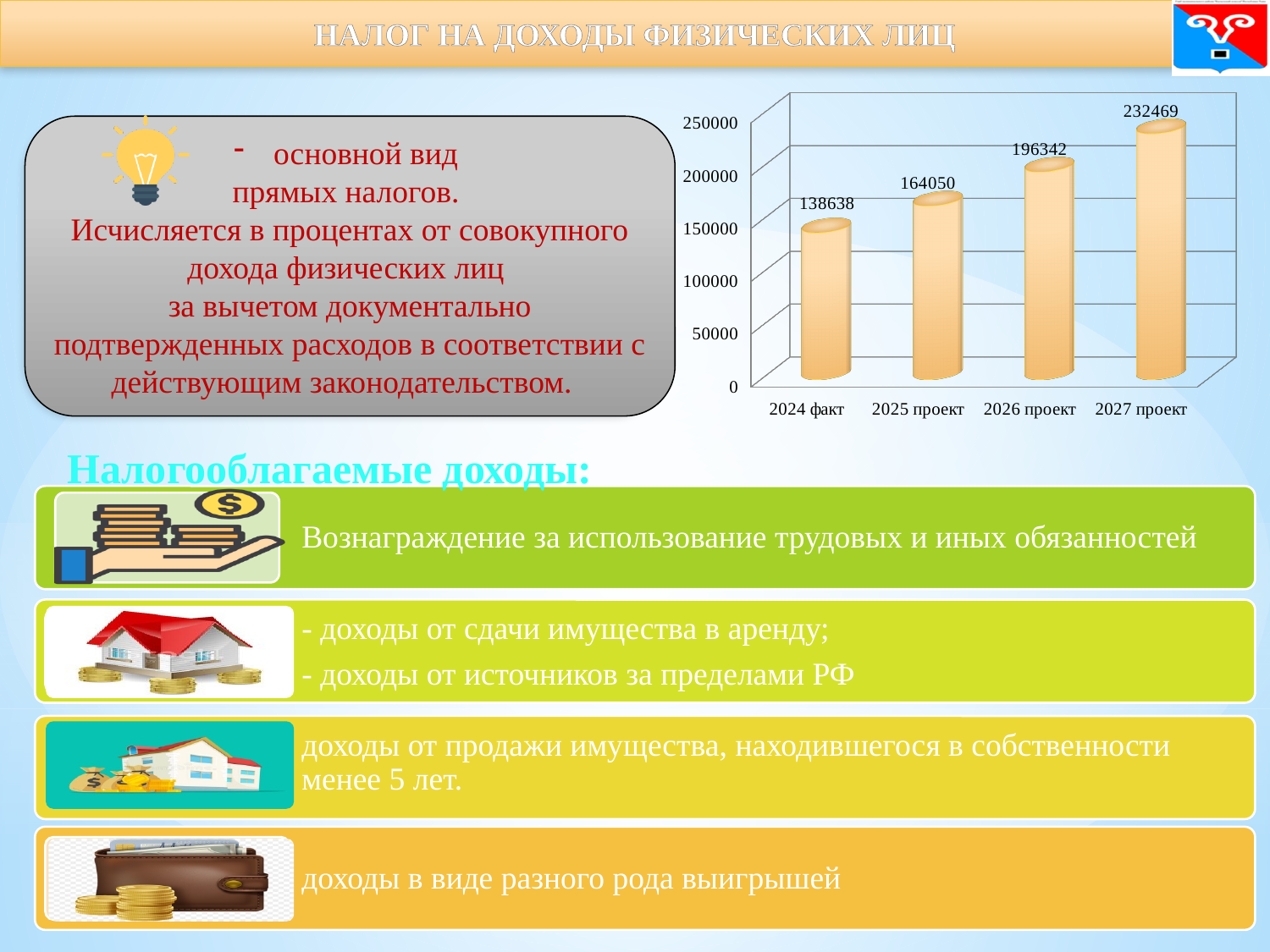
What is the value for 2027 проект? 232469 What is the value for 2025 проект? 164050 What is the difference between the values for 2026 проект and 2025 проект? 32292 What is the value for 2024 факт? 138638 Which is larger, the value for 2025 проект or the value for 2026 проект? 2026 проект Which category has the highest value? 2027 проект What is the value for 2026 проект? 196342 How many categories are shown on the x axis? 4 Is the value for 2026 проект greater or less than 200000? less What is the difference between the values for 2027 проект and 2024 факт? 93831 Which category has the lowest value? 2024 факт Do the values rise or fall from 2024 факт to 2027 проект? rise